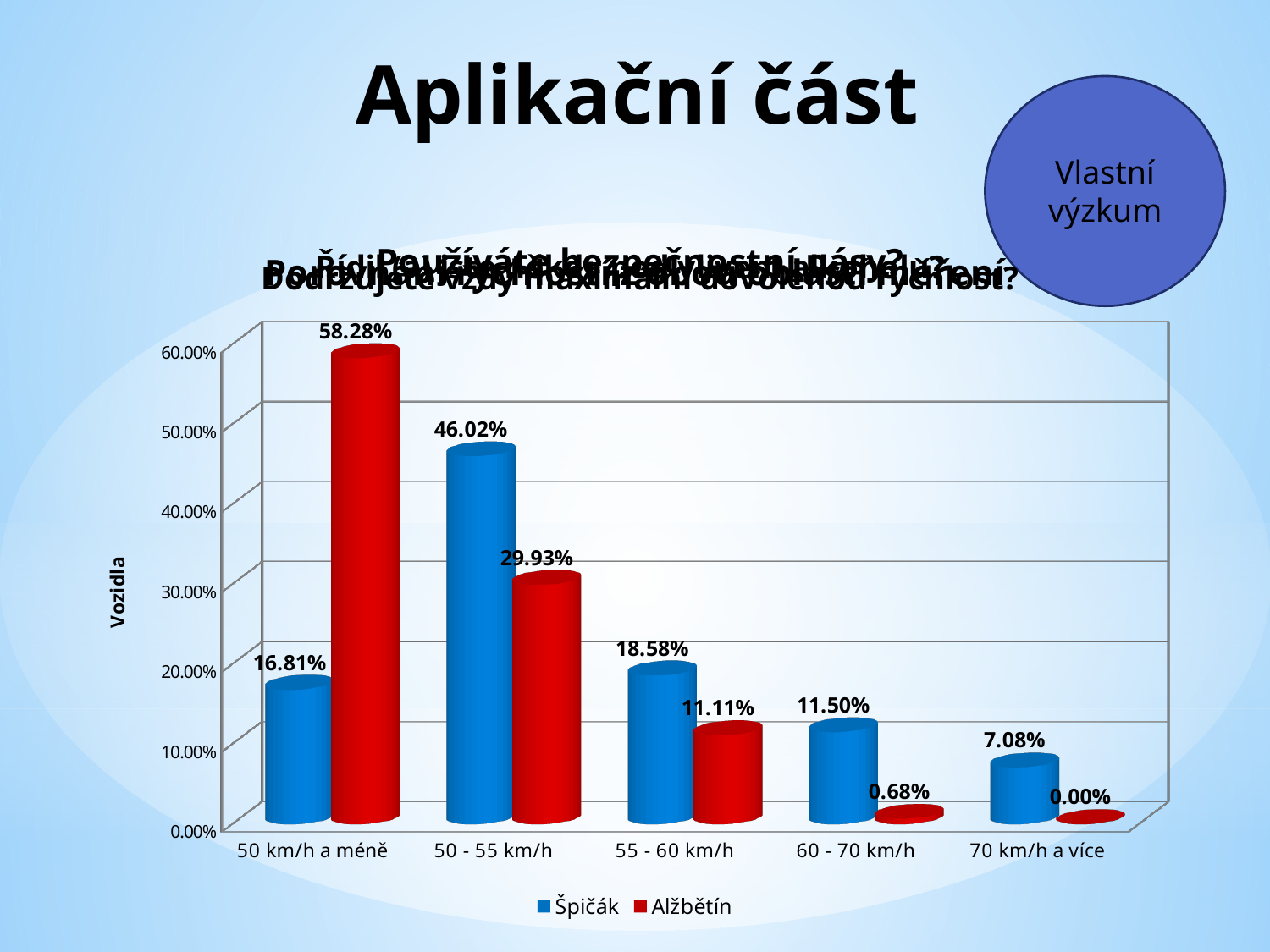
What is the value for Alžbětín in the 70 km/h a více category? 0.00% What is the value for Alžbětín in the 50 km/h a méně category? 58.28% Which category has the lowest value for Špičák? 70 km/h a více Which category has the highest value for Alžbětín? 50 km/h a méně What is the value for Špičák in the 60 - 70 km/h category? 11.50% How many categories are shown on the x axis? 5 What is the label of the vertical axis? Vozidla How many series does the legend list? 2 In the 55 - 60 km/h category, which series has the larger value, Špičák or Alžbětín? Špičák What is the difference between the Alžbětín and Špičák values in the 50 km/h a méně category? 41.47% What is the value for Špičák in the 50 - 55 km/h category? 46.02% What kind of chart is shown on the slide? bar chart